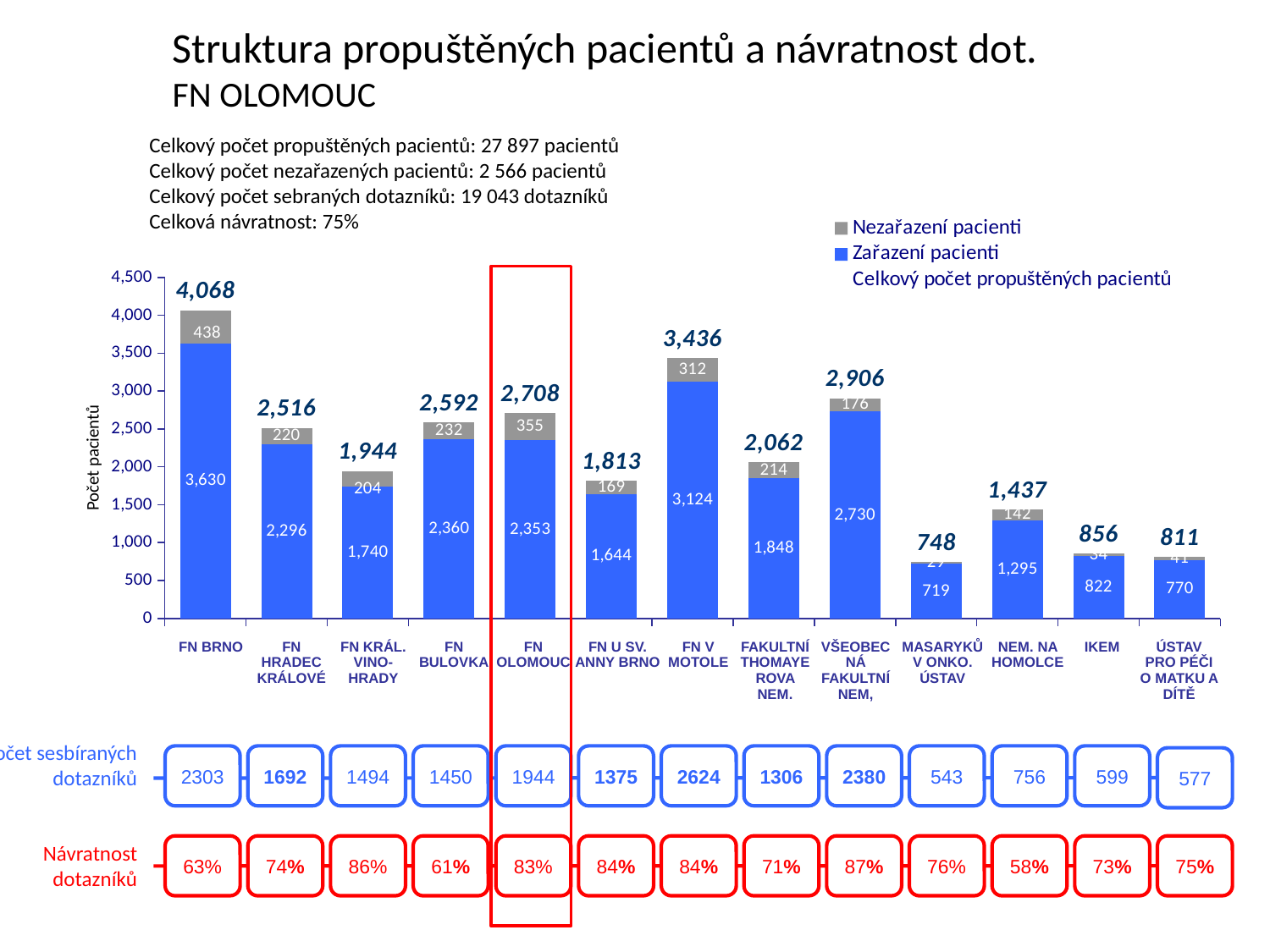
Which hospital has the lowest total number of discharged patients? MASARYKŮV ONKO. ÚSTAV What is the value of Nezařazení pacienti for FN BRNO? 438 Which hospital has the highest total number of discharged patients? FN BRNO What is the label of the y axis of the chart? Počet pacientů How many hospitals (categories) are shown on the x axis of the chart? 13 What is the value of Zařazení pacienti for FN OLOMOUC? 2,353 What is the difference between the Zařazení pacienti values for FN BRNO and FN V MOTOLE? 506 Is the total bar height for NEM. NA HOMOLCE greater or less than 1,500? less What is the total number of discharged patients (Celkový počet propuštěných pacientů) shown above the bar for FN V MOTOLE? 3,436 Which has a larger total of discharged patients, FN BULOVKA or FN HRADEC KRÁLOVÉ? FN BULOVKA What type of chart is shown on the slide? bar chart How many series does the chart legend list? 3